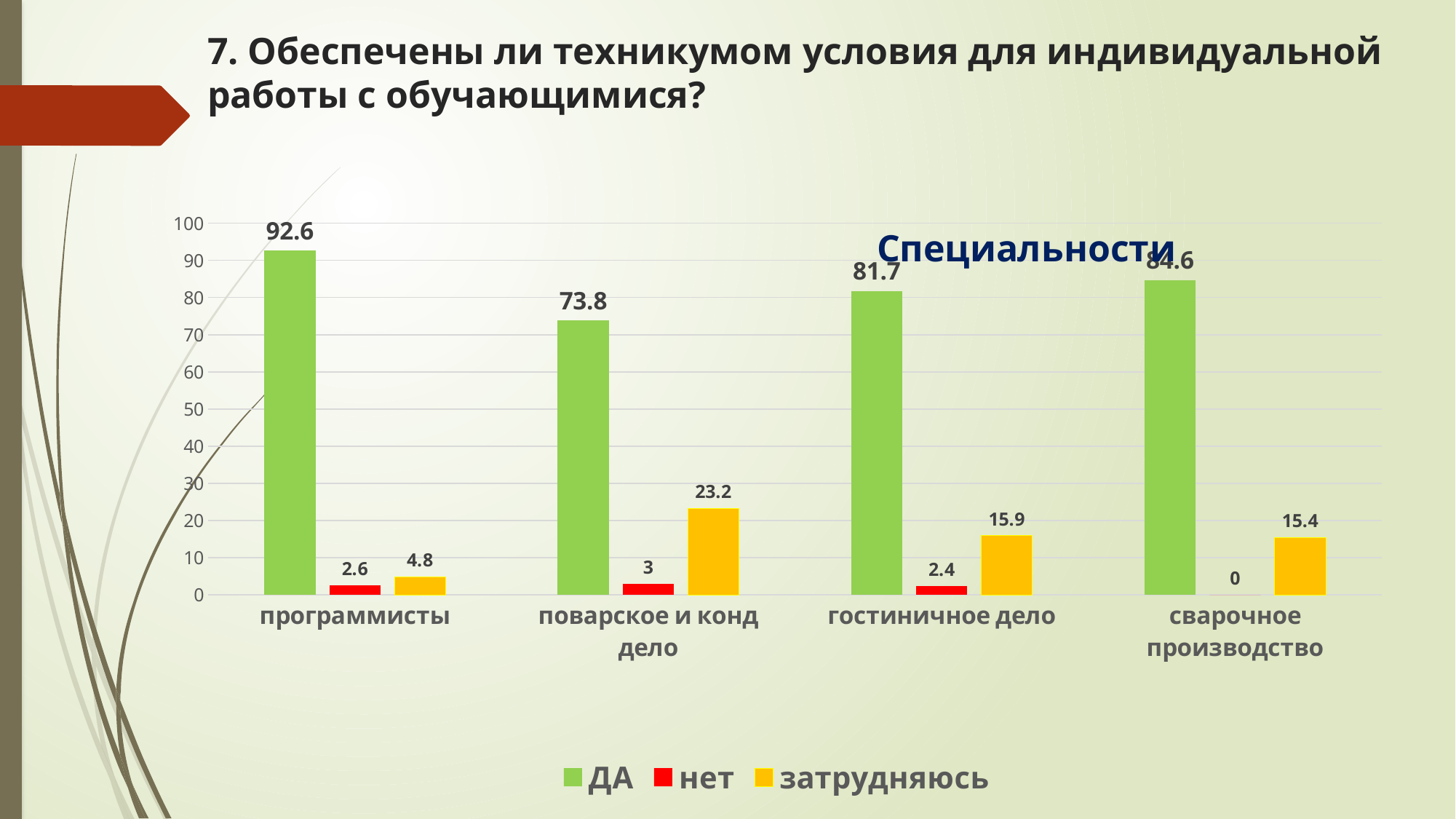
What is the difference between the ДА values for программисты and поварское и конд дело? 18.8 Which category has the highest value in the ДА series? программисты Which is larger: the затрудняюсь value for гостиничное дело or for сварочное производство? гостиничное дело What is the value of the затрудняюсь series for поварское и конд дело? 23.2 How many categories are shown on the x axis? 4 Which colour represents the нет series in the legend? red What is the value of the нет series for сварочное производство? 0 Which category has the lowest value in the ДА series? поварское и конд дело How many series does the legend list? 3 What is the value of the ДА series for программисты? 92.6 Is the ДА value for гостиничное дело greater or less than 80? greater What kind of chart is shown on the slide? bar chart